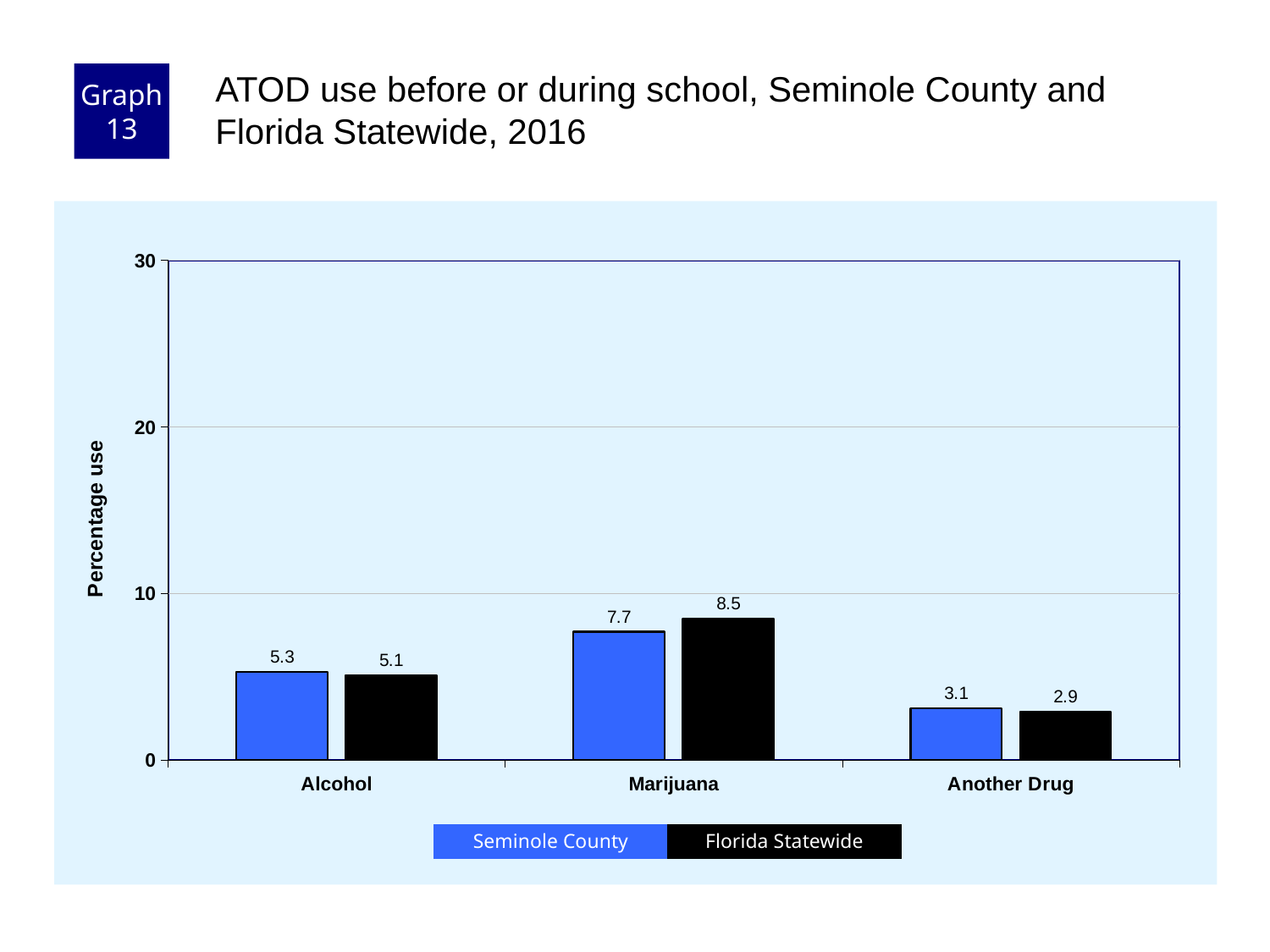
Is the Florida Statewide value for Marijuana greater or less than 10? less How many categories are shown on the x axis? 3 How many series does the legend list? 2 Which category has the highest Seminole County value? Marijuana What is the Florida Statewide value for Alcohol? 5.1 Which is larger for Another Drug, Seminole County or Florida Statewide? Seminole County What is the Seminole County value for Alcohol? 5.3 Which category has the lowest Florida Statewide value? Another Drug What is the Florida Statewide value for Marijuana? 8.5 What kind of chart is shown on the slide? bar chart What is the difference between the Florida Statewide and Seminole County values for Marijuana? 0.8 What is the Seminole County value for Another Drug? 3.1